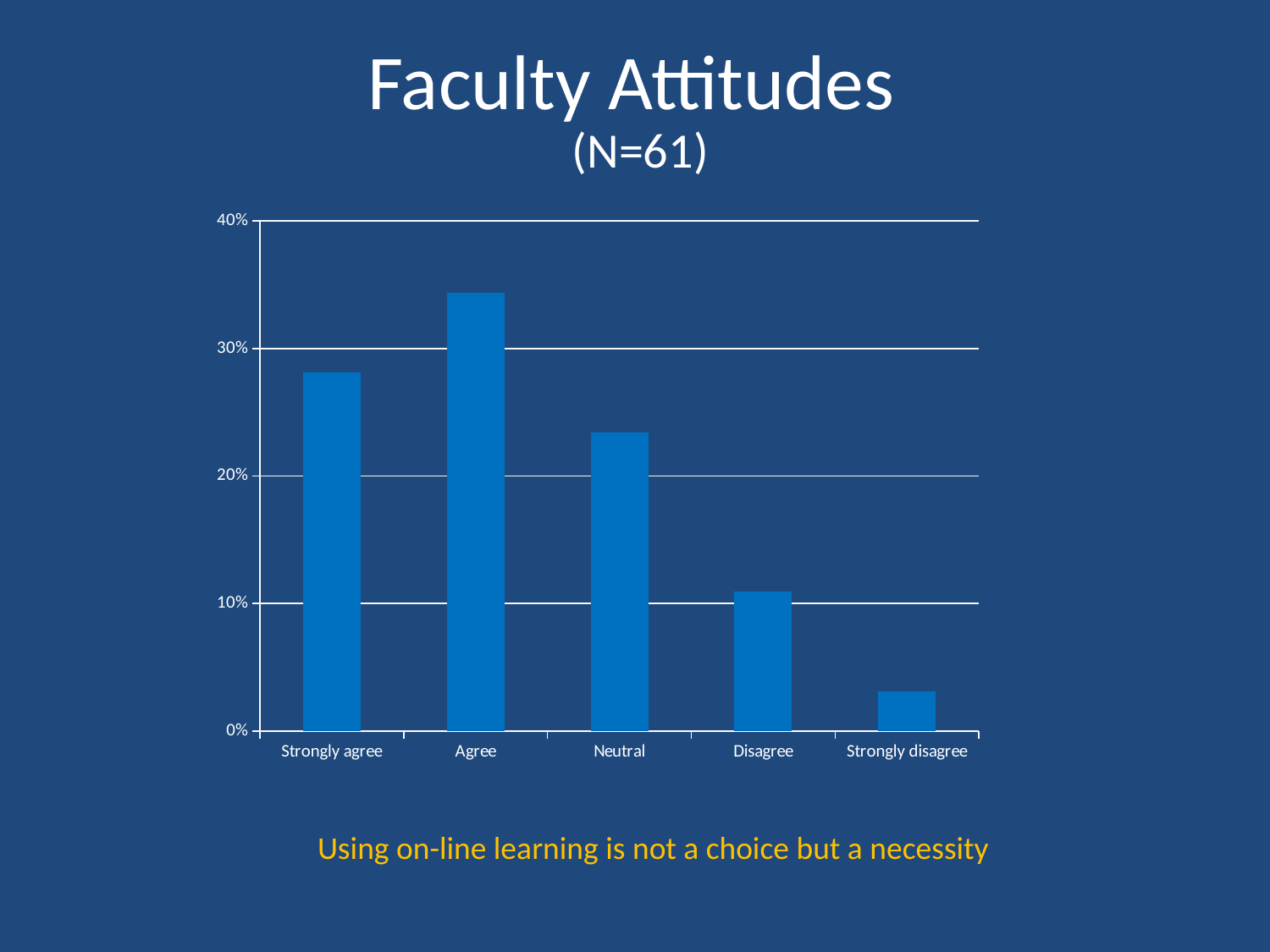
Which category has the lowest bar? Strongly disagree Is the value for Disagree greater or less than 20%? less Which category has the highest bar? Agree Which is larger, the value for Strongly agree or the value for Neutral? Strongly agree What kind of chart is shown on the slide? bar chart Is the value for Neutral greater or less than 30%? less Is the value for Agree greater or less than 30%? greater Which is larger, the value for Disagree or the value for Strongly disagree? Disagree How many categories are shown on the x axis of the chart? 5 What is the title of the slide containing the chart? Faculty Attitudes (N=61)